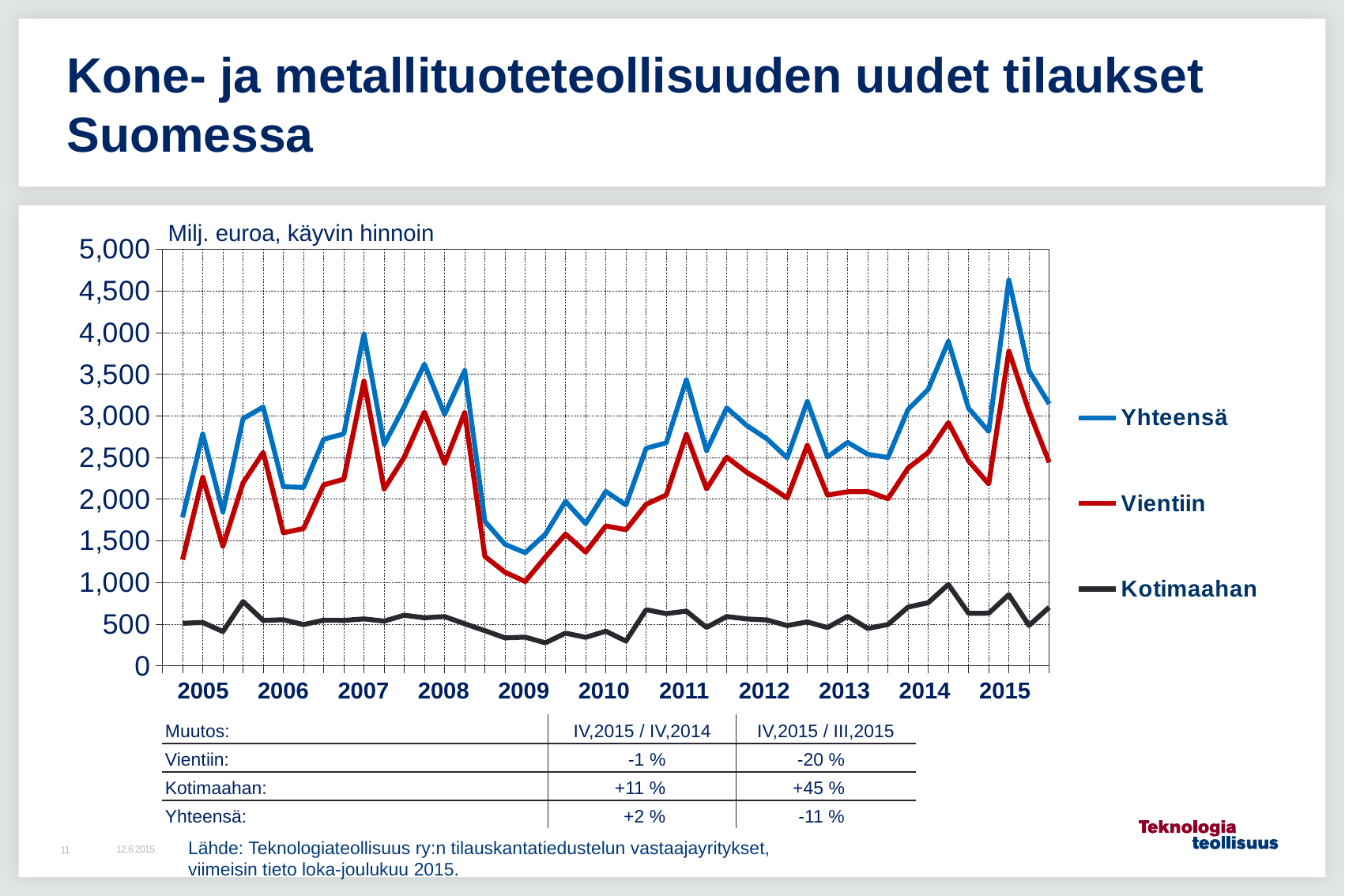
What unit label is shown above the y axis of the chart? Milj. euroa, käyvin hinnoin In which year does the Yhteensä series reach its highest peak? 2015 In which year does the Yhteensä series reach its lowest point? 2009 Which series is drawn in red on the chart? Vientiin Do the Yhteensä values rise or fall from the 2008 peak into 2009? fall How many years are labelled on the x axis of the chart? 11 Is the highest value of the Vientiin series greater or less than 3,500? greater Is the highest value of the Yhteensä series greater or less than 4,000? greater Which series has higher values throughout the chart, Vientiin or Kotimaahan? Vientiin How many series does the chart legend list? 3 What kind of chart is shown on the slide? line chart